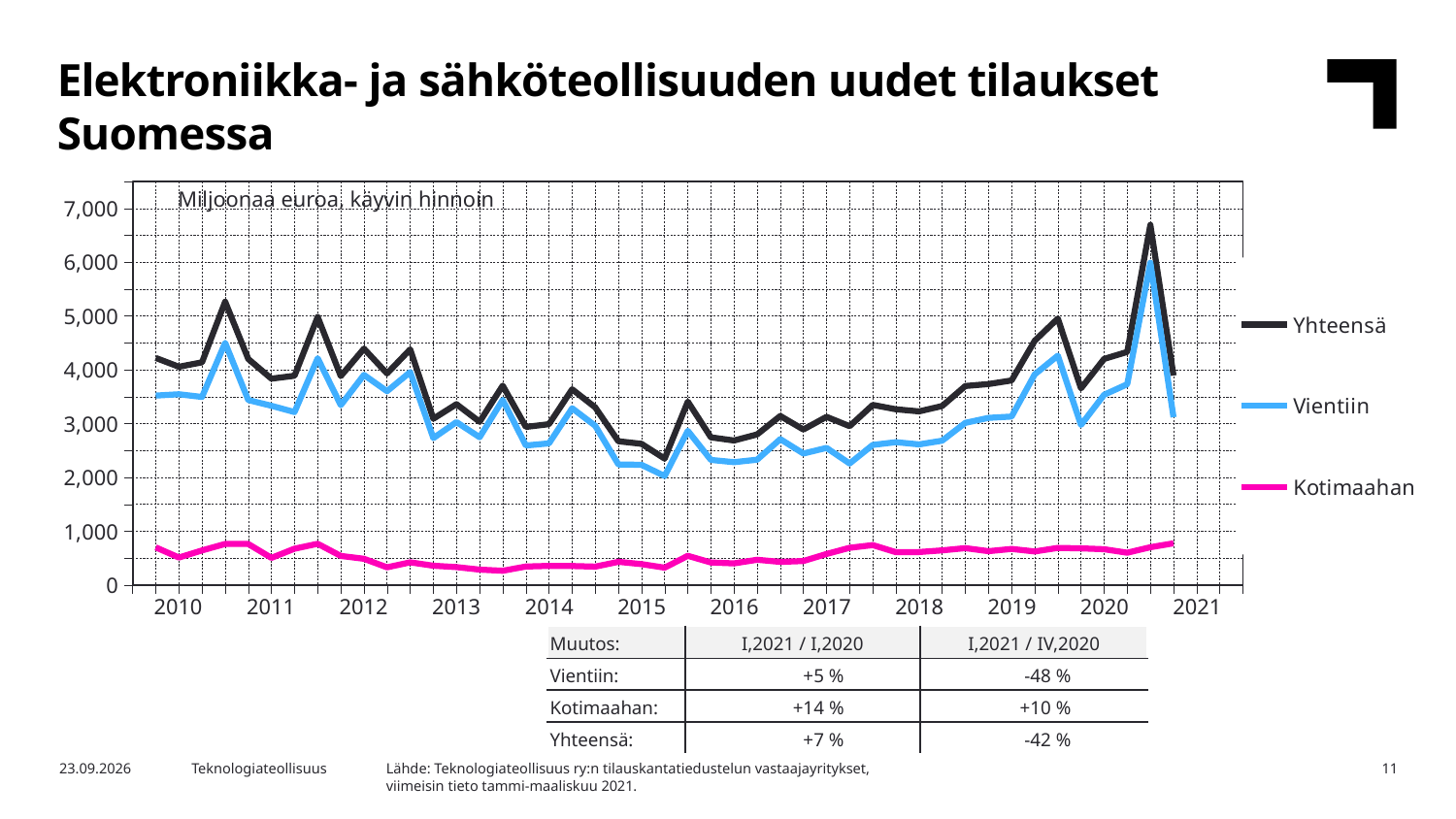
Is the lowest value of Vientiin around 2015 greater or less than 2,500? less Is the peak value of Yhteensä in 2020 greater or less than 6,000? greater What are the three series named in the chart's legend? Yhteensä, Vientiin, Kotimaahan Does the Yhteensä series generally rise or fall between 2010 and 2015? fall What unit label is printed inside the chart area? Miljoonaa euroa, käyvin hinnoin What kind of chart is shown on the slide? line chart Which series has the highest values throughout the chart? Yhteensä How many years are labeled on the x axis? 12 Is the value for Kotimaahan at the start of 2010 greater or less than 1,000? less How many series does the chart's legend list? 3 Which series has the lowest values throughout the chart? Kotimaahan